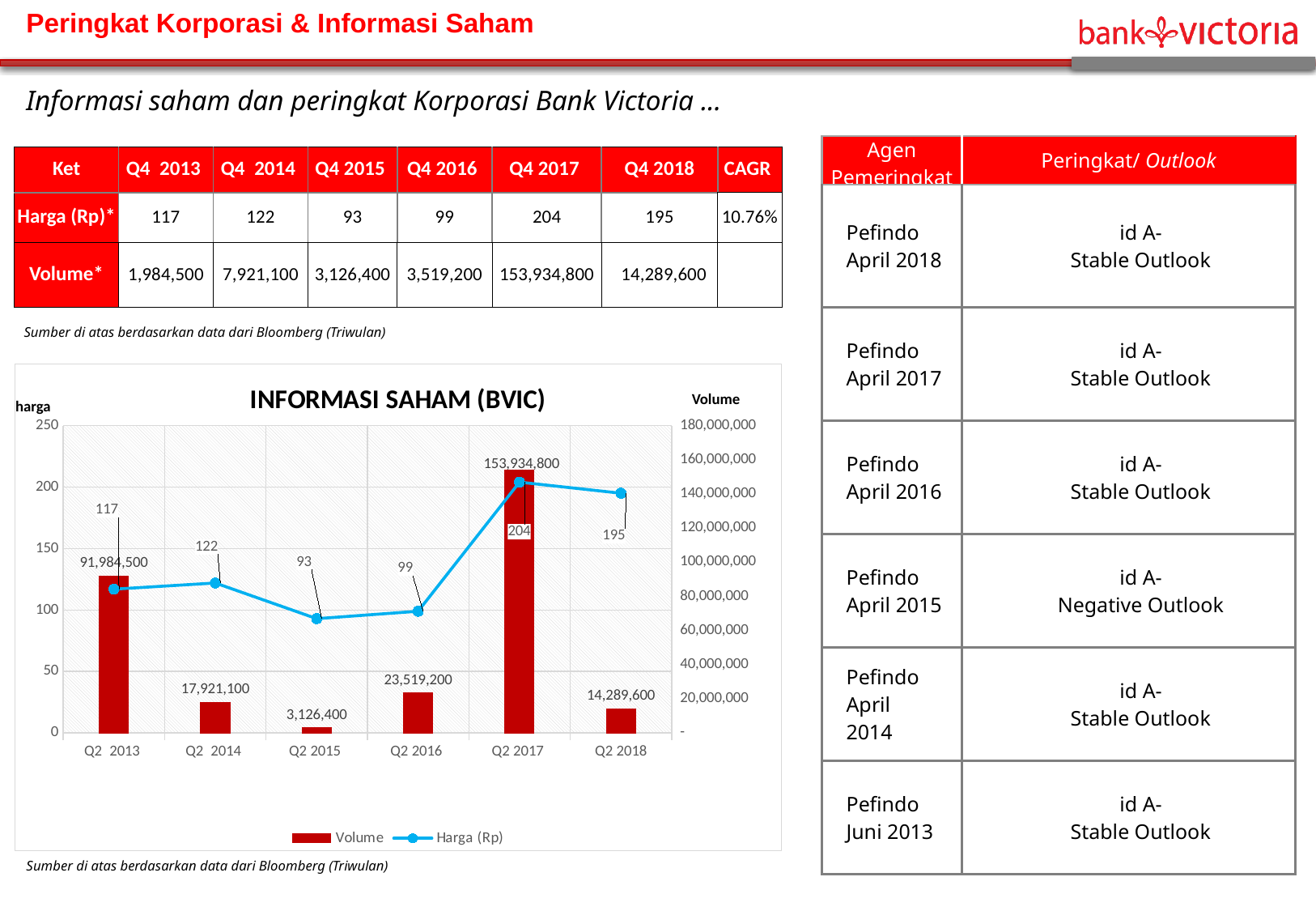
In the INFORMASI SAHAM (BVIC) chart, which quarter has the highest Volume? Q2 2017 What type of chart is INFORMASI SAHAM (BVIC)? Combination bar and line chart In the INFORMASI SAHAM (BVIC) chart, what is the Harga (Rp) value for Q2 2015? 93 In the INFORMASI SAHAM (BVIC) chart, what is the Volume for Q2 2018? 14,289,600 In the INFORMASI SAHAM (BVIC) chart, is the Volume for Q2 2015 greater or less than 20,000,000? less In the INFORMASI SAHAM (BVIC) chart, is the Harga (Rp) higher in Q2 2014 or Q2 2016? Q2 2014 How many quarters are shown on the x axis of the INFORMASI SAHAM (BVIC) chart? 6 In the INFORMASI SAHAM (BVIC) chart, what is the Harga (Rp) value for Q2 2017? 204 In the INFORMASI SAHAM (BVIC) chart, what is the difference in Harga (Rp) between Q2 2017 and Q2 2018? 9 In the INFORMASI SAHAM (BVIC) chart, what is the Volume for Q2 2017? 153,934,800 In the INFORMASI SAHAM (BVIC) chart, which quarter has the lowest Harga (Rp)? Q2 2015 How many series does the legend of the INFORMASI SAHAM (BVIC) chart list? 2